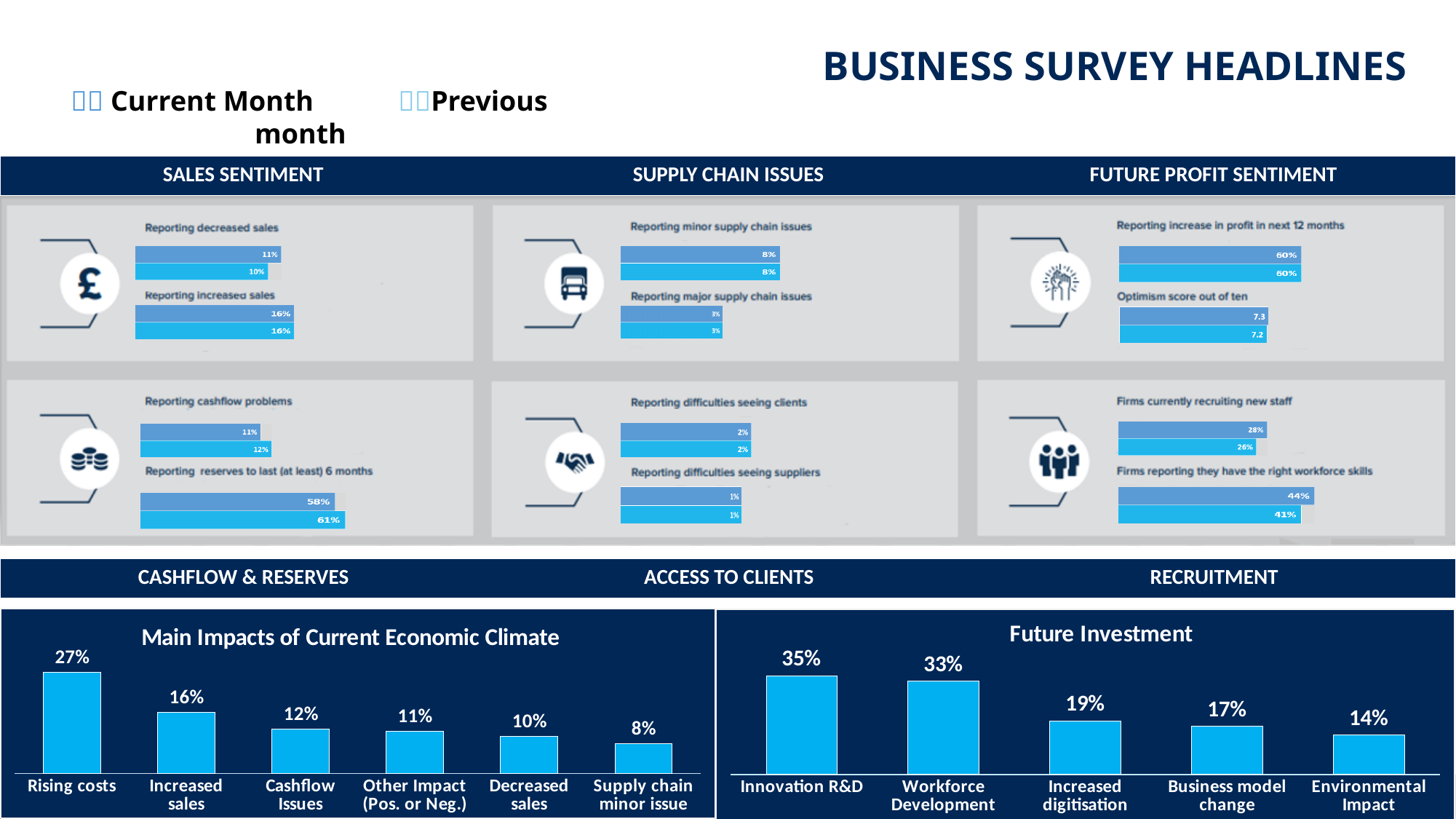
In the 'Future Investment' chart, what is the value for Increased digitisation? 19% In the 'Future Investment' chart, which category has the highest value? Innovation R&D In the 'Main Impacts of Current Economic Climate' chart, which category has the lowest value? Supply chain minor issue In the 'Future Investment' chart, what is the difference between Innovation R&D and Workforce Development? 2% In the 'Future Investment' chart, which is larger: Business model change or Environmental Impact? Business model change In the 'Main Impacts of Current Economic Climate' chart, what is the value for Rising costs? 27% In the 'Main Impacts of Current Economic Climate' chart, what is the difference between Rising costs and Increased sales? 11% How many categories are shown in the 'Future Investment' chart? 5 In the 'Main Impacts of Current Economic Climate' chart, do the values rise or fall from left to right? fall What type of chart is the 'Future Investment' chart? bar chart How many categories are shown in the 'Main Impacts of Current Economic Climate' chart? 6